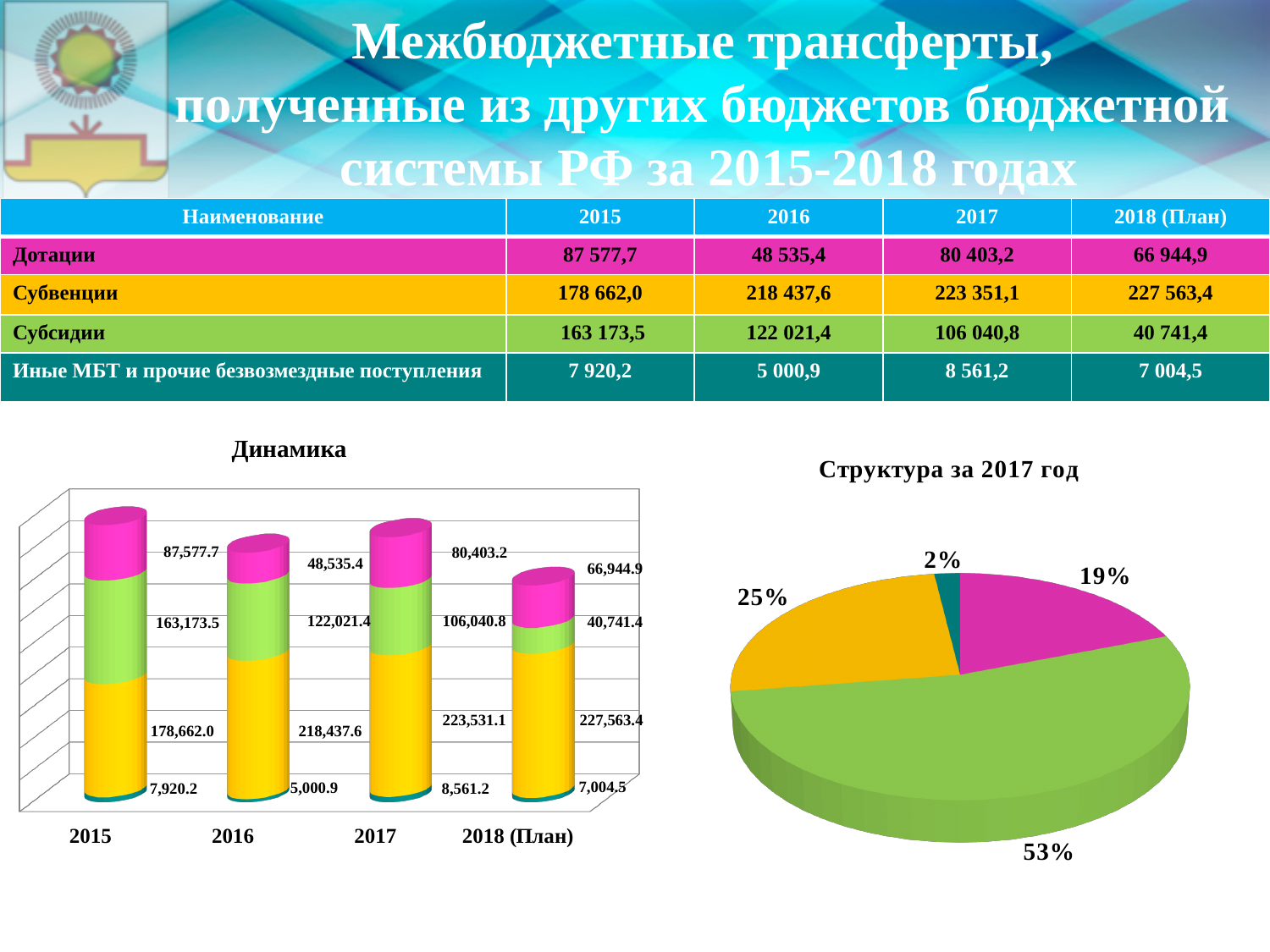
In the "Структура за 2017 год" chart, what is the share of the largest slice? 53% In the "Динамика" chart, what is the value of the pink (top) segment for 2015? 87,577.7 In the "Динамика" chart, what is the total of the stacked bar for 2018 (План)? 342,254.2 In the "Структура за 2017 год" chart, what is the share of the smallest slice? 2% In the "Динамика" chart, how many years are shown on the x axis? 4 In the "Динамика" chart, is the green segment larger in 2015 or in 2018 (План)? 2015 In the "Динамика" chart, what is the value of the smallest (bottom) segment for 2017? 8,561.2 What kind of chart is the "Динамика" chart? bar chart In the "Динамика" chart, what is the difference between the pink segment values for 2015 and 2016? 39,042.3 In the "Динамика" chart, what is the value of the yellow segment for 2016? 218,437.6 In the "Динамика" chart, what is the value of the green segment for 2018 (План)? 40,741.4 What kind of chart is the "Структура за 2017 год" chart? pie chart